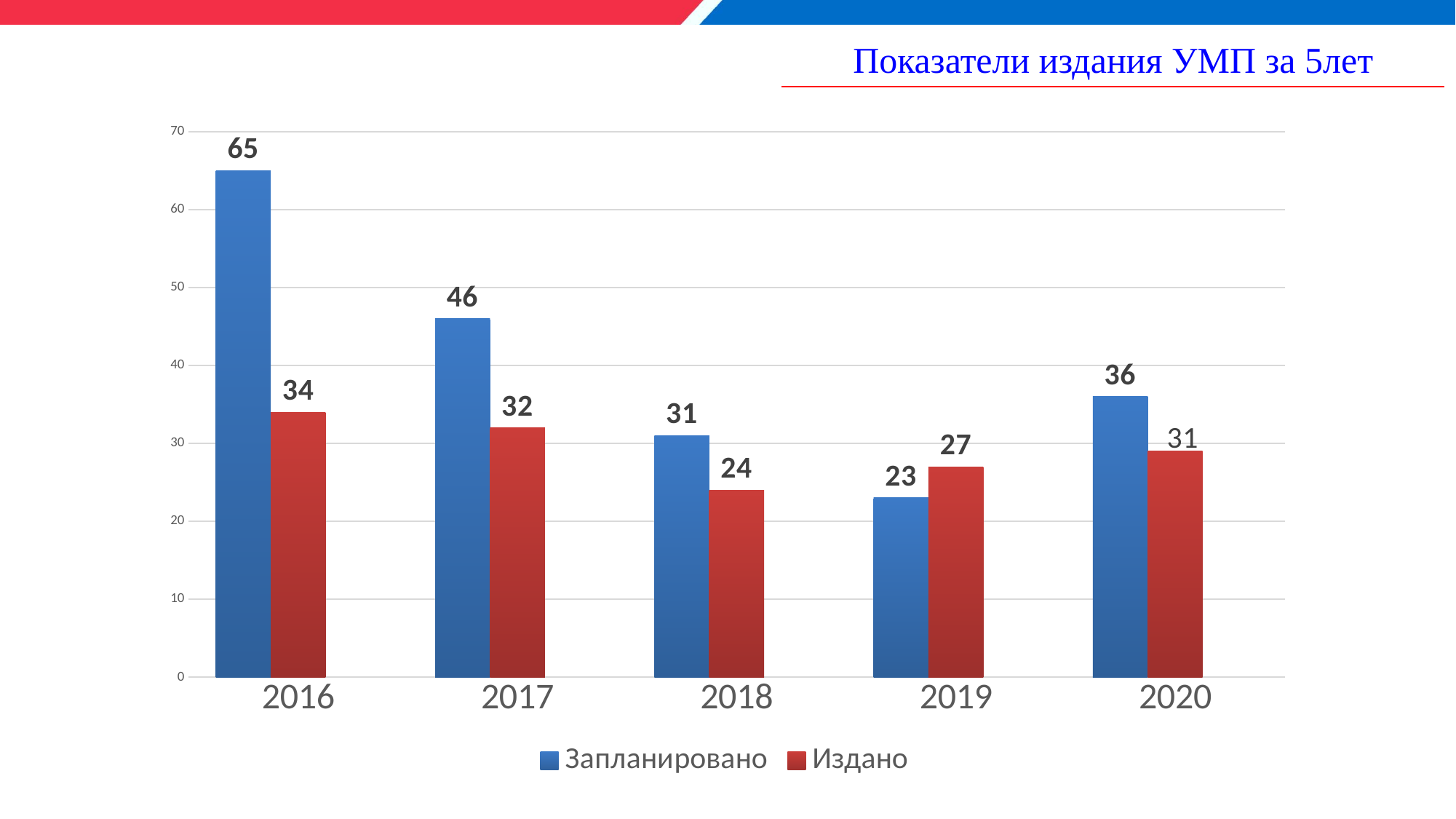
What kind of chart is shown on the slide? Bar chart Does the Запланировано value rise or fall from 2016 to 2019? Fall Which year has the highest Запланировано value? 2016 Which year has the lowest Издано value? 2018 What colour are the Издано bars? Red In 2019, which is larger: Запланировано or Издано? Издано What is the value for Издано in 2019? 27 What is the value for Запланировано in 2016? 65 What is the value for Издано in 2020? 31 How many series does the legend list? 2 What is the difference between Запланировано and Издано in 2017? 14 How many years are shown on the x axis? 5